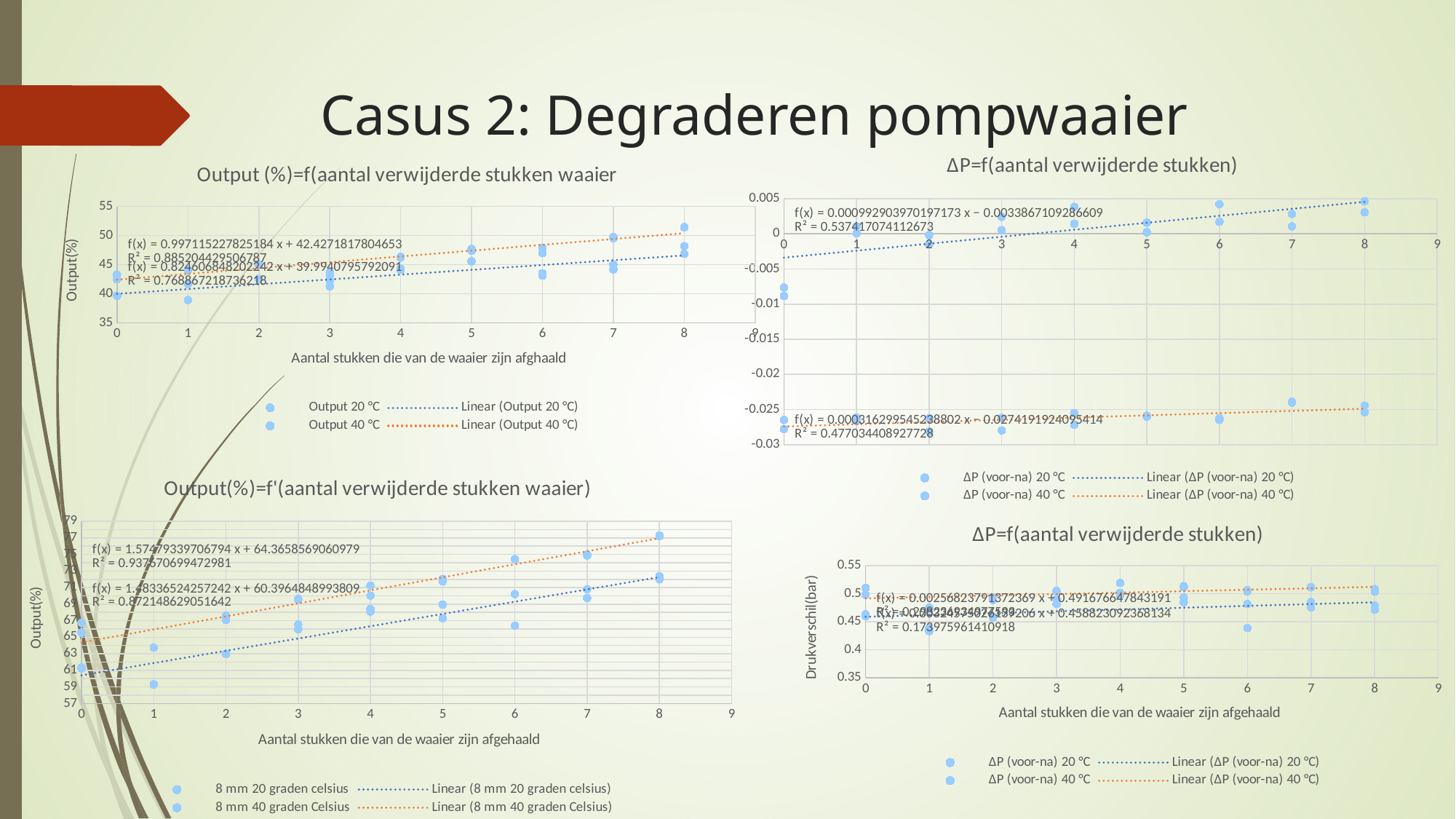
In the bottom-left chart "Output(%)=f'(aantal verwijderde stukken waaier)", what is the R² value printed for the trendline with equation f(x) = 1.57479339706794 x + 64.3658569060979? 0.937570699472981 What kind of chart is the top-left chart titled "Output (%)=f(aantal verwijderde stukken waaier"? Scatter chart In the bottom-right chart "ΔP=f(aantal verwijderde stukken)", are all plotted values greater or less than 0.4? greater In the top-right chart "ΔP=f(aantal verwijderde stukken)", are the values of the ΔP (voor-na) 40 °C series greater or less than -0.02? less In the top-left chart "Output (%)=f(aantal verwijderde stukken waaier", how many entries does the legend list? 4 In the top-left chart "Output (%)=f(aantal verwijderde stukken waaier", what is the R² value printed for the trendline with equation f(x) = 0.997115227825184 x + 42.4271817804653? 0.885204429506787 In the top-right chart "ΔP=f(aantal verwijderde stukken)", what R² value is printed for the trendline with equation f(x) = 0.000316299545238802 x − 0.0274191924095414? 0.477034408927728 In the top-left chart "Output (%)=f(aantal verwijderde stukken waaier", do the output values rise or fall as the number of removed pieces increases? Rise In the bottom-right chart "ΔP=f(aantal verwijderde stukken)", what is the label of the vertical axis? Drukverschil(bar) In the top-right chart "ΔP=f(aantal verwijderde stukken)", which series has the higher values: ΔP (voor-na) 20 °C or ΔP (voor-na) 40 °C? ΔP (voor-na) 20 °C In the bottom-left chart "Output(%)=f'(aantal verwijderde stukken waaier)", are the plotted values at x = 8 greater or less than 70? greater In the bottom-left chart "Output(%)=f'(aantal verwijderde stukken waaier)", what are the two data series named in the legend? 8 mm 20 graden celsius and 8 mm 40 graden Celsius